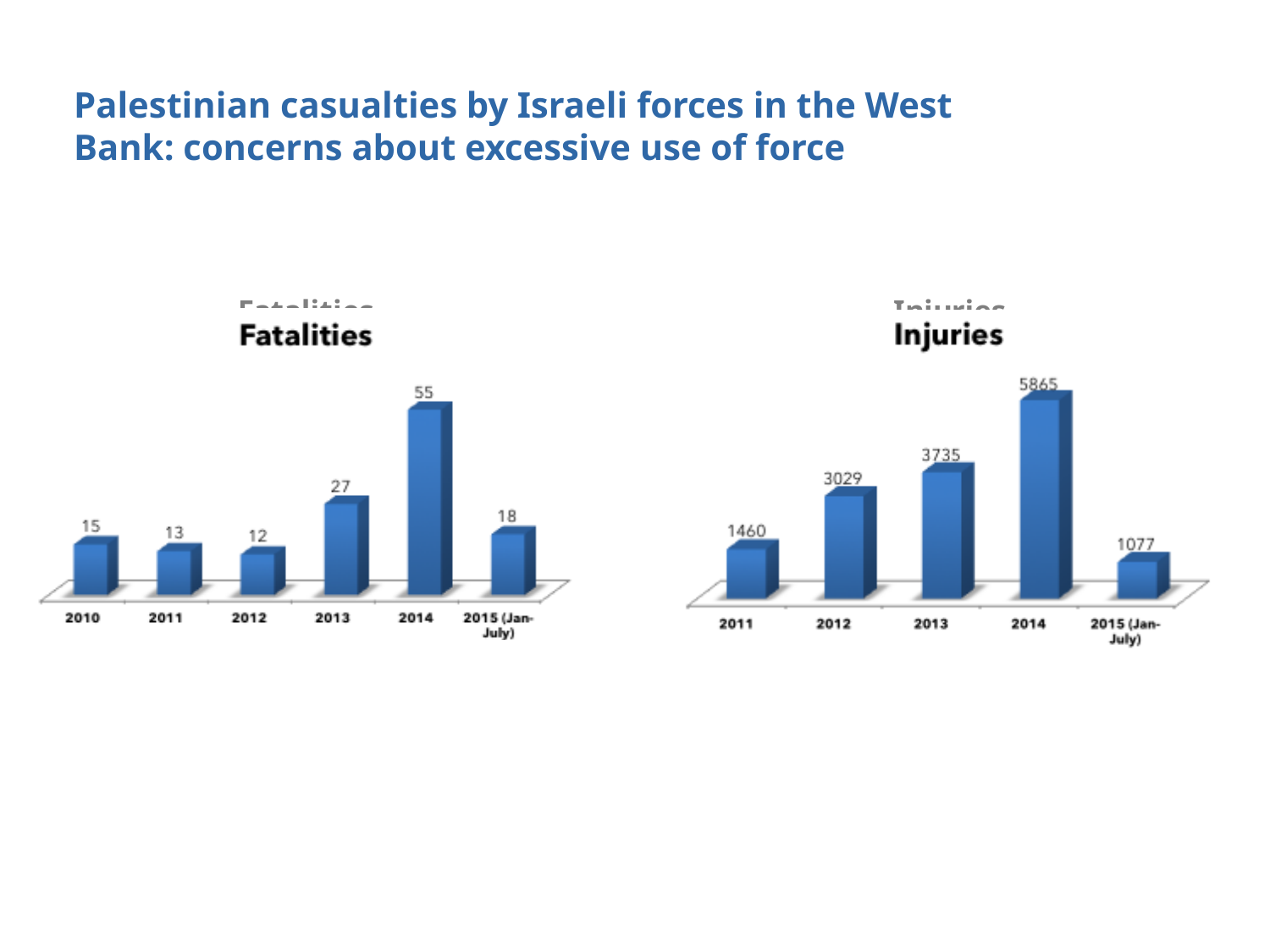
In the Injuries chart, which year has the highest value? 2014 How many categories are shown in the Fatalities chart? 6 In the Fatalities chart, what is the value for 2010? 15 In the Injuries chart, what is the value for 2013? 3735 In the Injuries chart, what is the value for 2015 (Jan-July)? 1077 In the Fatalities chart, what is the value for 2014? 55 In the Fatalities chart, which year has the lowest value? 2012 In the Injuries chart, which is larger, the value for 2011 or the value for 2015 (Jan-July)? 2011 What kind of chart is the Injuries chart? Bar chart In the Injuries chart, what is the difference between the values for 2014 and 2013? 2130 How many categories are shown in the Injuries chart? 5 In the Fatalities chart, what is the difference between the values for 2014 and 2013? 28